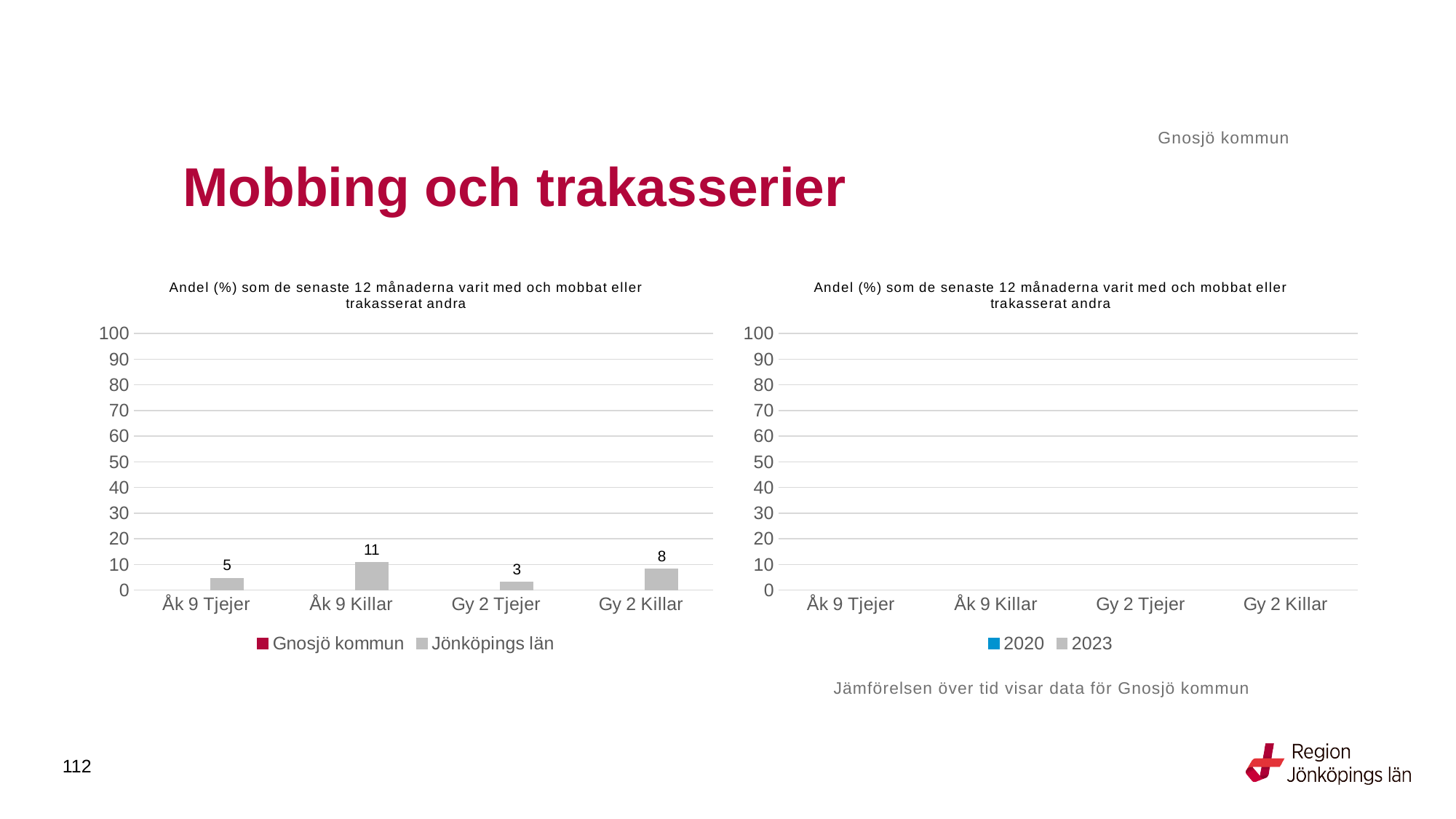
In the left chart, what is the value for Jönköpings län for Åk 9 Killar? 11 In the left chart, what is the value for Jönköpings län for Åk 9 Tjejer? 5 In the left chart, what is the value for Jönköpings län for Gy 2 Tjejer? 3 In the left chart, what is the difference between the Jönköpings län values for Åk 9 Killar and Åk 9 Tjejer? 6 How many series does the legend of the right chart list? 2 In the left chart, is the value for Jönköpings län for Åk 9 Killar greater or less than 20? less In the left chart, which category has the lowest value for Jönköpings län? Gy 2 Tjejer In the left chart, which category has the highest value for Jönköpings län? Åk 9 Killar What type of chart is the left chart? bar chart In the left chart, which is larger for Jönköpings län: Gy 2 Killar or Gy 2 Tjejer? Gy 2 Killar In the left chart, what is the value for Jönköpings län for Gy 2 Killar? 8 How many categories are shown on the x axis of the left chart? 4